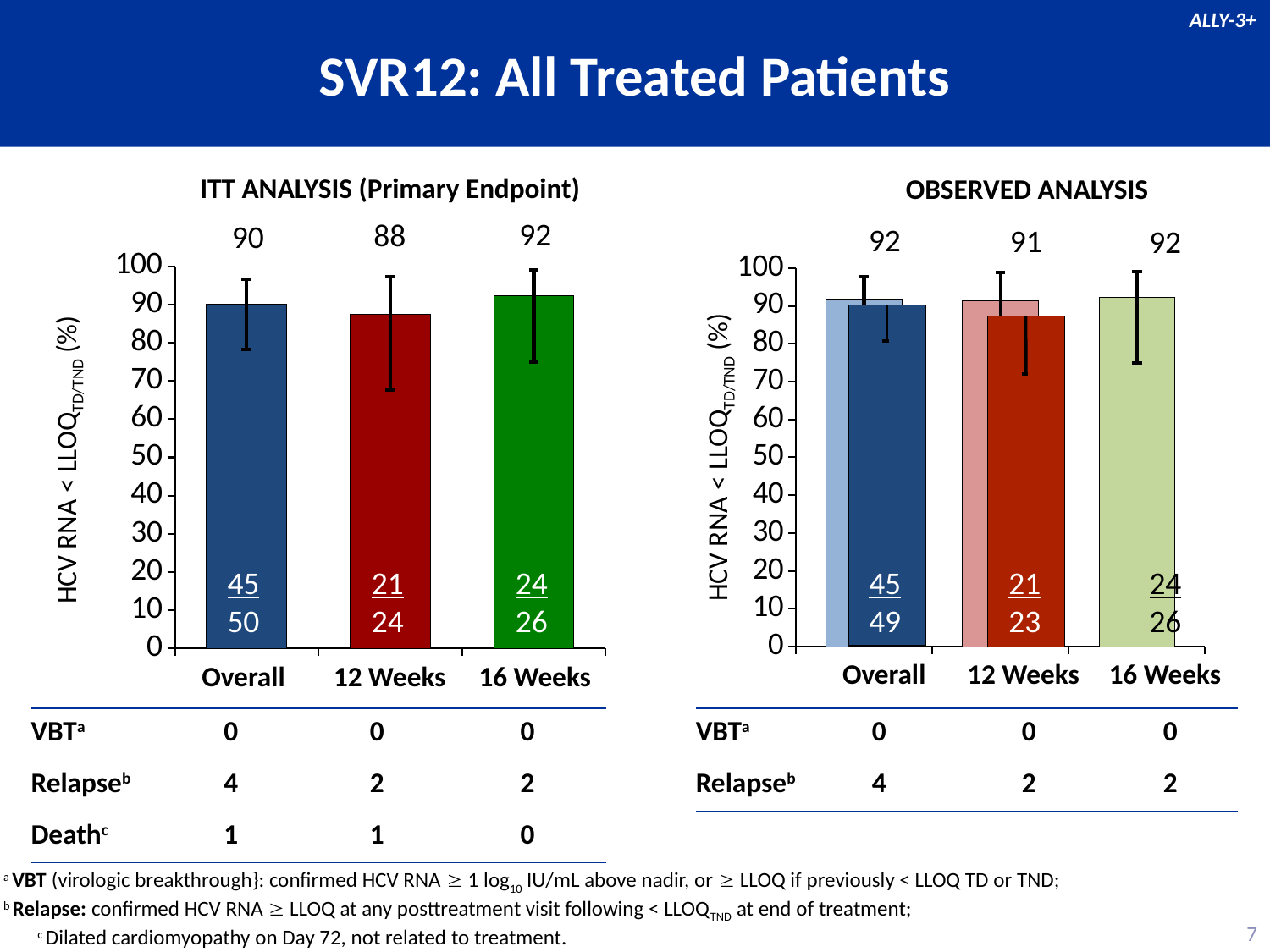
What kind of chart is the ITT Analysis chart? Bar chart In the ITT Analysis chart, what is the SVR12 value for Overall? 90 In the ITT Analysis chart, is the value for 12 Weeks greater or less than 80? greater How many categories are shown on the x axis of the Observed Analysis chart? 3 In the ITT Analysis chart, what is the value for 12 Weeks? 88 In the ITT Analysis chart, which is larger, the Overall value or the 12 Weeks value? Overall In the ITT Analysis chart, which category has the lowest value? 12 Weeks In the ITT Analysis chart, which category has the highest value? 16 Weeks In the Observed Analysis chart, what is the value for 16 Weeks? 92 In the Observed Analysis chart, which category has the lowest value? 12 Weeks In the ITT Analysis chart, what is the difference between the 16 Weeks and 12 Weeks values? 4 In the Observed Analysis chart, what is the value for 12 Weeks? 91